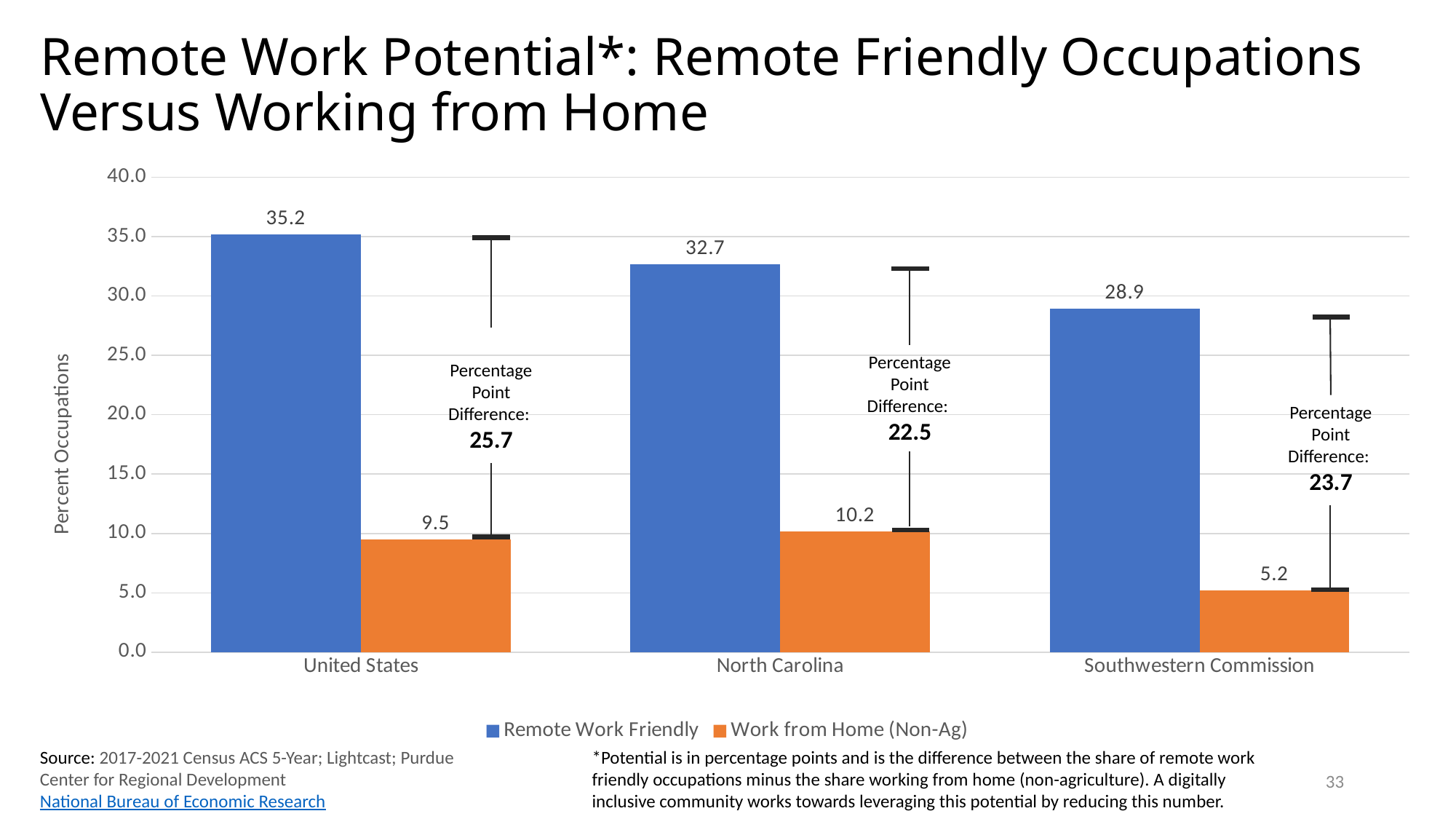
What is the Work from Home (Non-Ag) value for North Carolina? 10.2 Which is larger, the Work from Home (Non-Ag) value for the United States or for North Carolina? North Carolina What is the difference between the Remote Work Friendly and Work from Home (Non-Ag) values for North Carolina? 22.5 What is the Work from Home (Non-Ag) value for Southwestern Commission? 5.2 What is the difference between the Remote Work Friendly values for the United States and Southwestern Commission? 6.3 What kind of chart is shown on the slide? bar chart How many regions are shown on the x axis? 3 Which region has the lowest Work from Home (Non-Ag) value? Southwestern Commission Is the Remote Work Friendly value for Southwestern Commission greater or less than 30.0? less What is the Remote Work Friendly value for the United States? 35.2 Which region has the highest Remote Work Friendly value? United States How many series does the legend list? 2